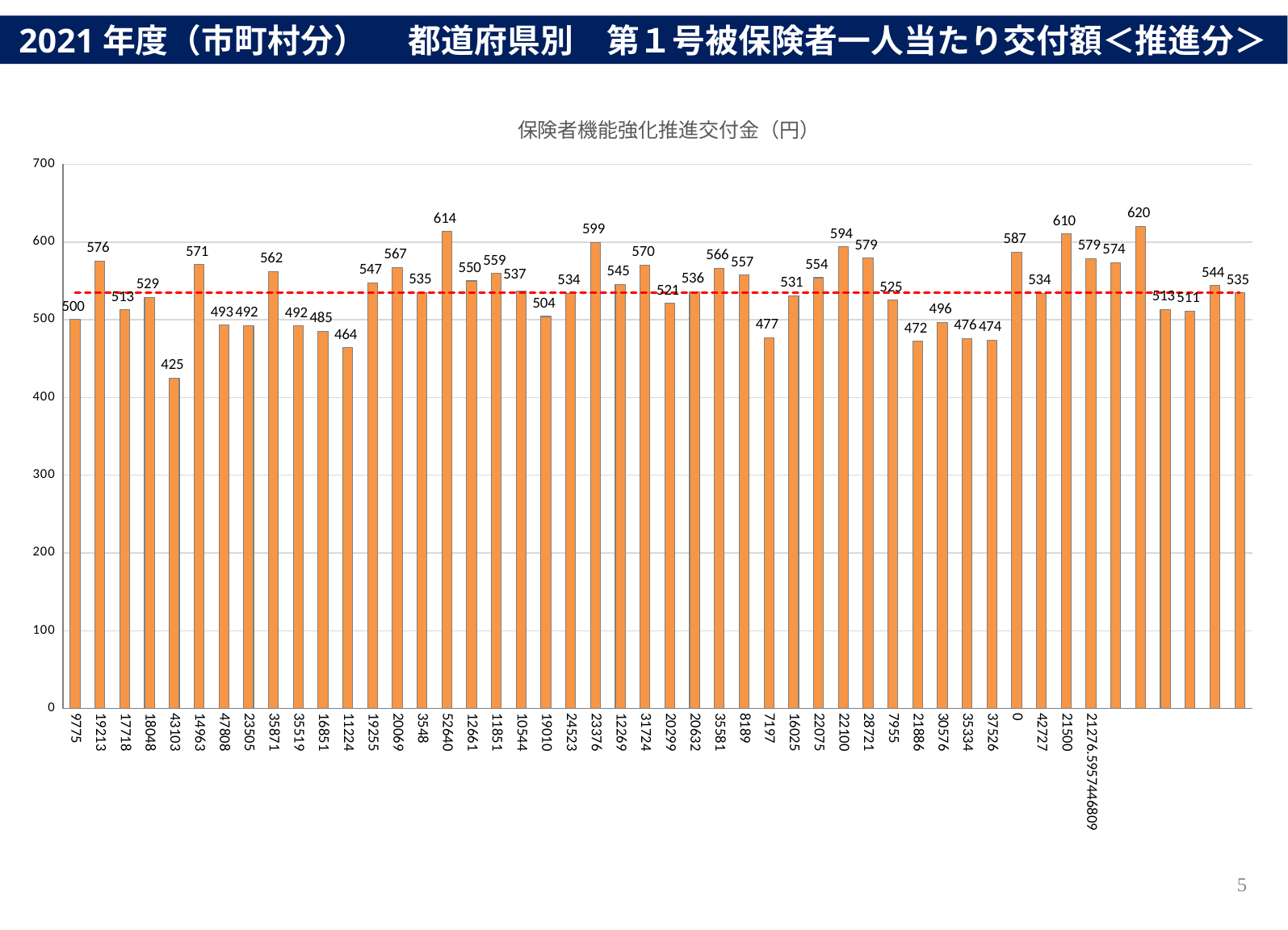
What is the value of the first bar, labelled 9775 on the x axis? 500 What kind of chart is shown on the slide? bar chart What is the title of the chart? 保険者機能強化推進交付金（円） What is the value of the bar labelled 52640 on the x axis? 614 Which bar is taller: the one labelled 52640 or the one labelled 23376? 52640 What is the value of the bar labelled 0 on the x axis? 587 Is the value for the bar labelled 43103 greater or less than 500? less What is the difference between the highest bar (620) and the lowest bar (425)? 195 What is the value of the bar labelled 43103 on the x axis? 425 What is the highest value shown by a data label on the chart? 620 What colour is the dashed horizontal reference line drawn across the chart? red What is the lowest value shown by a data label on the chart? 425